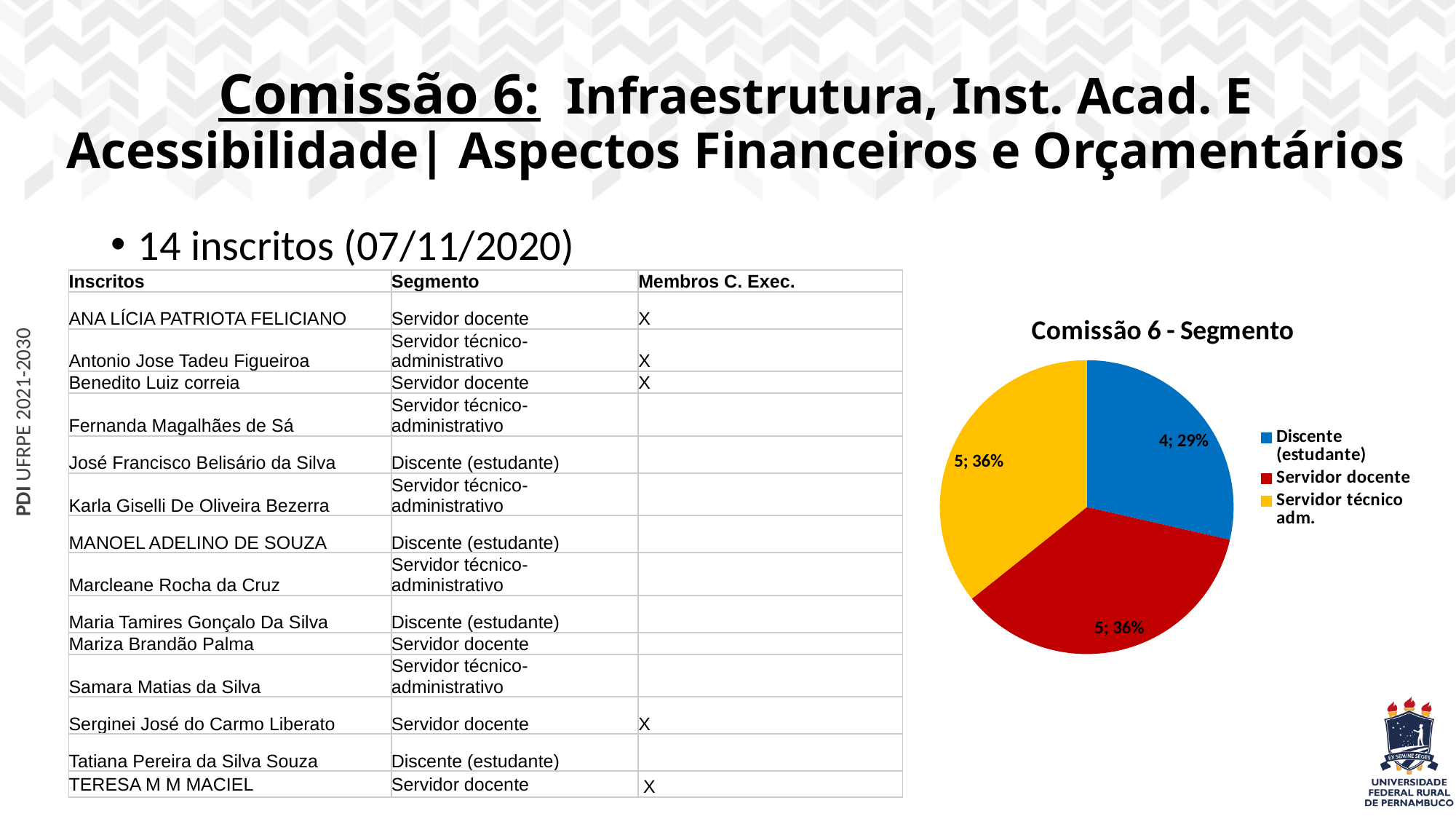
What is the count shown for the Servidor técnico adm. slice? 5 What type of chart is shown on the slide? pie chart What is the count shown for the Discente (estudante) slice? 4 What is the difference between the count for Servidor técnico adm. and the count for Discente (estudante)? 1 Which is larger, the Servidor docente slice or the Discente (estudante) slice? Servidor docente How many slices does the pie chart have? 3 What percentage share of the pie does Servidor docente represent? 36% How many entries does the chart legend list? 3 What percentage share of the pie does Discente (estudante) represent? 29% Which segment has the smallest slice in the pie chart? Discente (estudante) What is the title of the chart? Comissão 6 - Segmento What is the count shown for the Servidor docente slice? 5